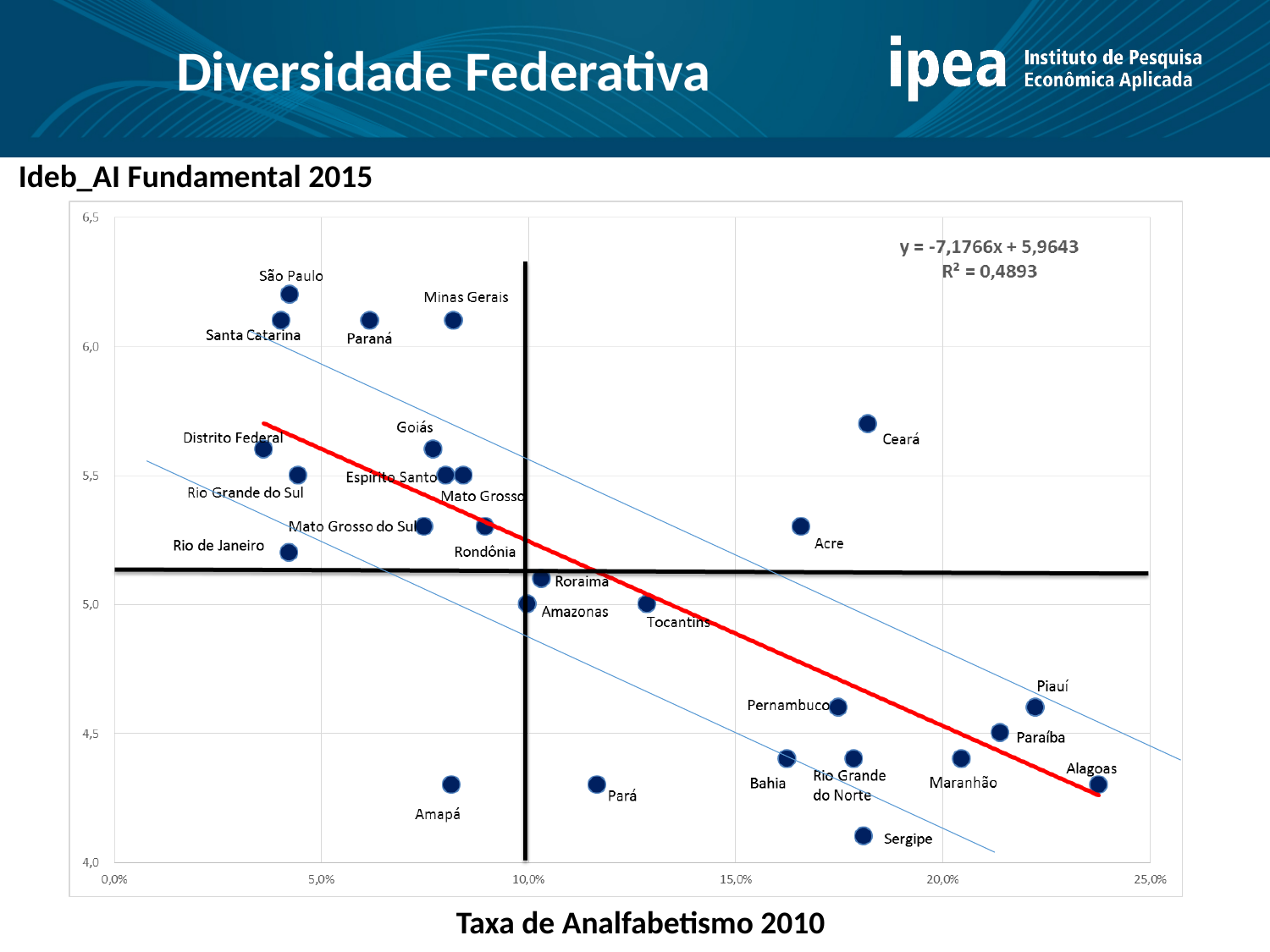
What is the R² value shown on the chart? R² = 0,4893 Which state has the highest Ideb_AI Fundamental 2015 value? São Paulo Is the Taxa de Analfabetismo for Alagoas greater or less than 20,0%? greater As the Taxa de Analfabetismo increases, does the Ideb value generally rise or fall? fall What kind of chart is shown on the slide? scatter chart Which state has the highest Taxa de Analfabetismo 2010? Alagoas Is the Ideb value for Sergipe greater or less than 4,5? less Which state has the lowest Ideb_AI Fundamental 2015 value? Sergipe Is the Ideb value for Ceará greater or less than 5,5? greater Which has a higher Ideb value, Amapá or Minas Gerais? Minas Gerais Which has a higher Ideb value, Ceará or Acre? Ceará